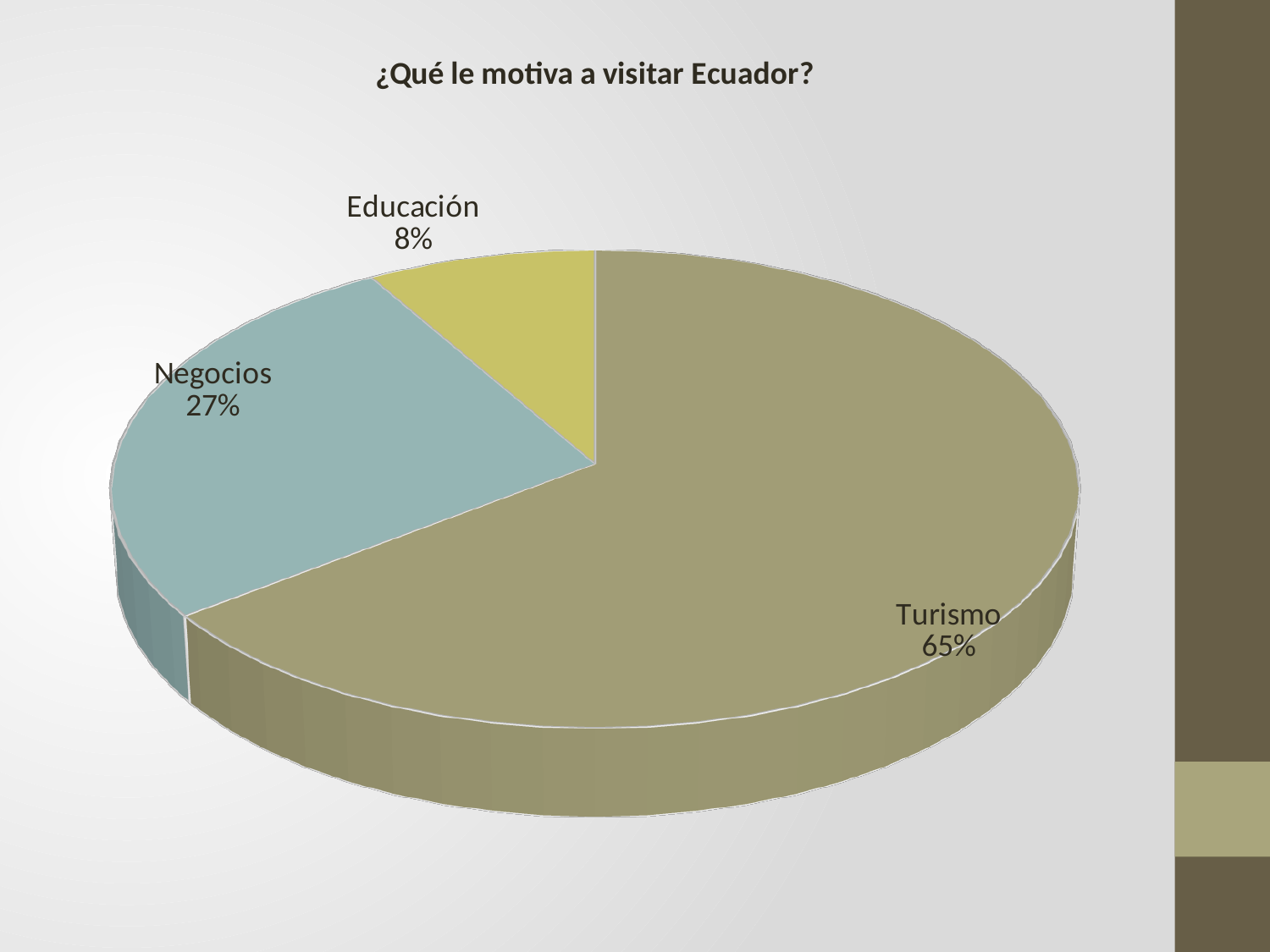
What share of the pie does Turismo represent? 65% How many categories are shown in the pie chart? 3 Which category has the largest slice of the pie? Turismo What kind of chart is shown on the slide? Pie chart What is the difference in percentage points between Negocios and Educación? 19 Which is larger, the slice for Negocios or the slice for Educación? Negocios What is the value shown for Negocios? 27% What is the title of the chart? ¿Qué le motiva a visitar Ecuador? What is the difference in percentage points between Turismo and Negocios? 38 What is the value shown for Educación? 8% What colour is the Educación slice? Yellow Which category has the smallest slice of the pie? Educación